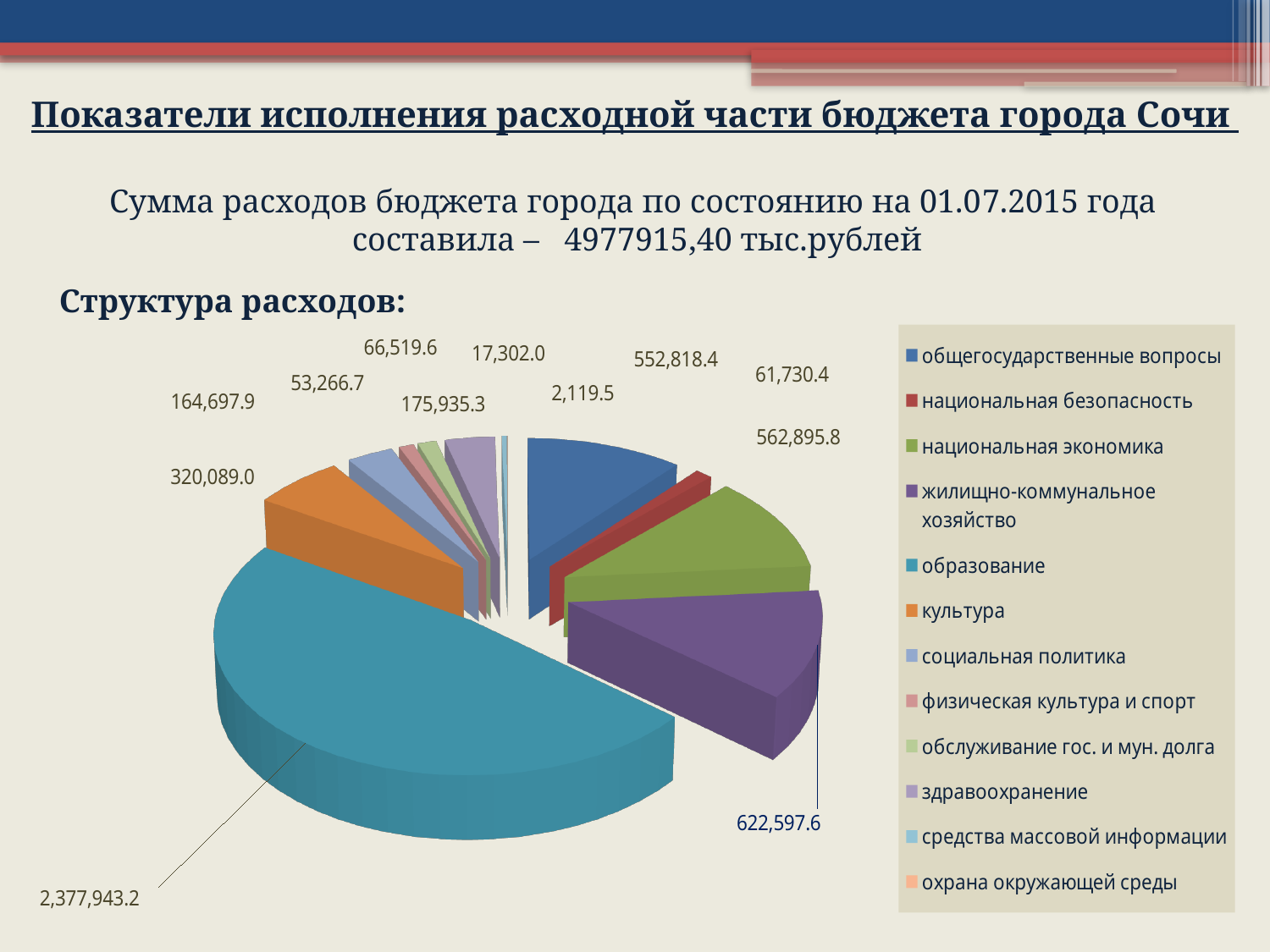
Which is larger, the value for образование or the value for жилищно-коммунальное хозяйство? образование What is the difference between the values for жилищно-коммунальное хозяйство and национальная экономика? 59,701.8 What is the value shown for культура? 320,089.0 What heading appears directly above the pie chart? Структура расходов: How many categories does the legend of the pie chart list? 12 What is the value shown for национальная экономика? 562,895.8 What is the value shown for общегосударственные вопросы? 552,818.4 Which category has the largest slice in the pie chart? образование What is the value shown for жилищно-коммунальное хозяйство? 622,597.6 What is the value shown for образование? 2,377,943.2 What kind of chart is shown on the slide? pie chart Which category has the smallest slice in the pie chart? охрана окружающей среды